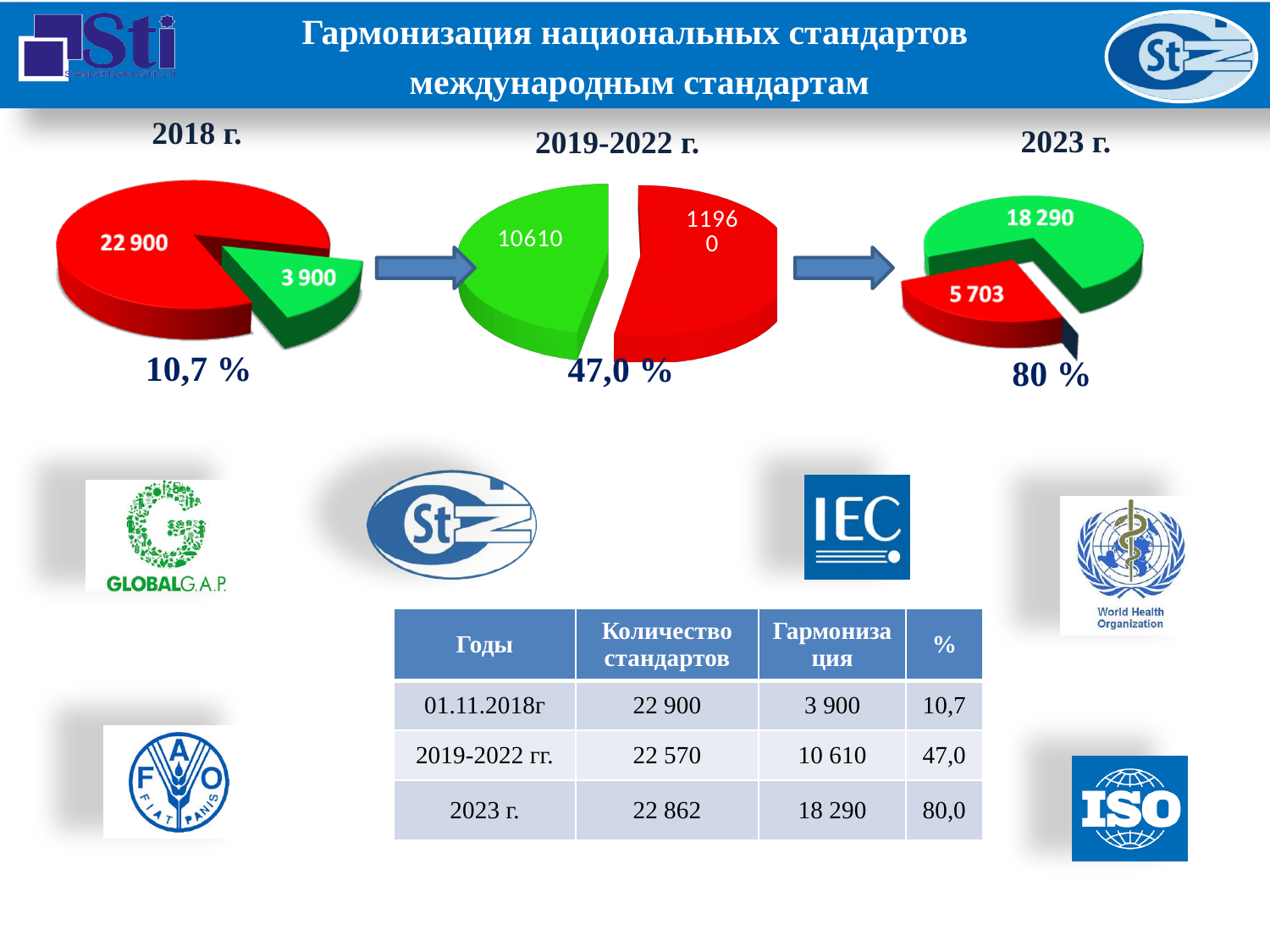
In the 2023 г. pie chart, which slice has the largest value? the green slice (18 290) How many slices does the 2019-2022 г. pie chart have? 2 In the 2018 г. pie chart, what is the value of the red slice? 22 900 In the 2018 г. pie chart, what is the value of the green slice? 3 900 What kind of chart is used for the 2018 г. data? pie chart In the 2023 г. pie chart, what is the value of the green slice? 18 290 In the 2023 г. pie chart, what is the value of the red slice? 5 703 In the 2018 г. pie chart, what is the difference between the red slice and the green slice? 19 000 In the 2023 г. pie chart, what is the difference between the green slice and the red slice? 12 587 In the 2019-2022 г. pie chart, what is the value of the green slice? 10610 In the 2018 г. pie chart, which slice is larger, the red one or the green one? the red one What percentage is printed below the 2023 г. pie chart? 80 %